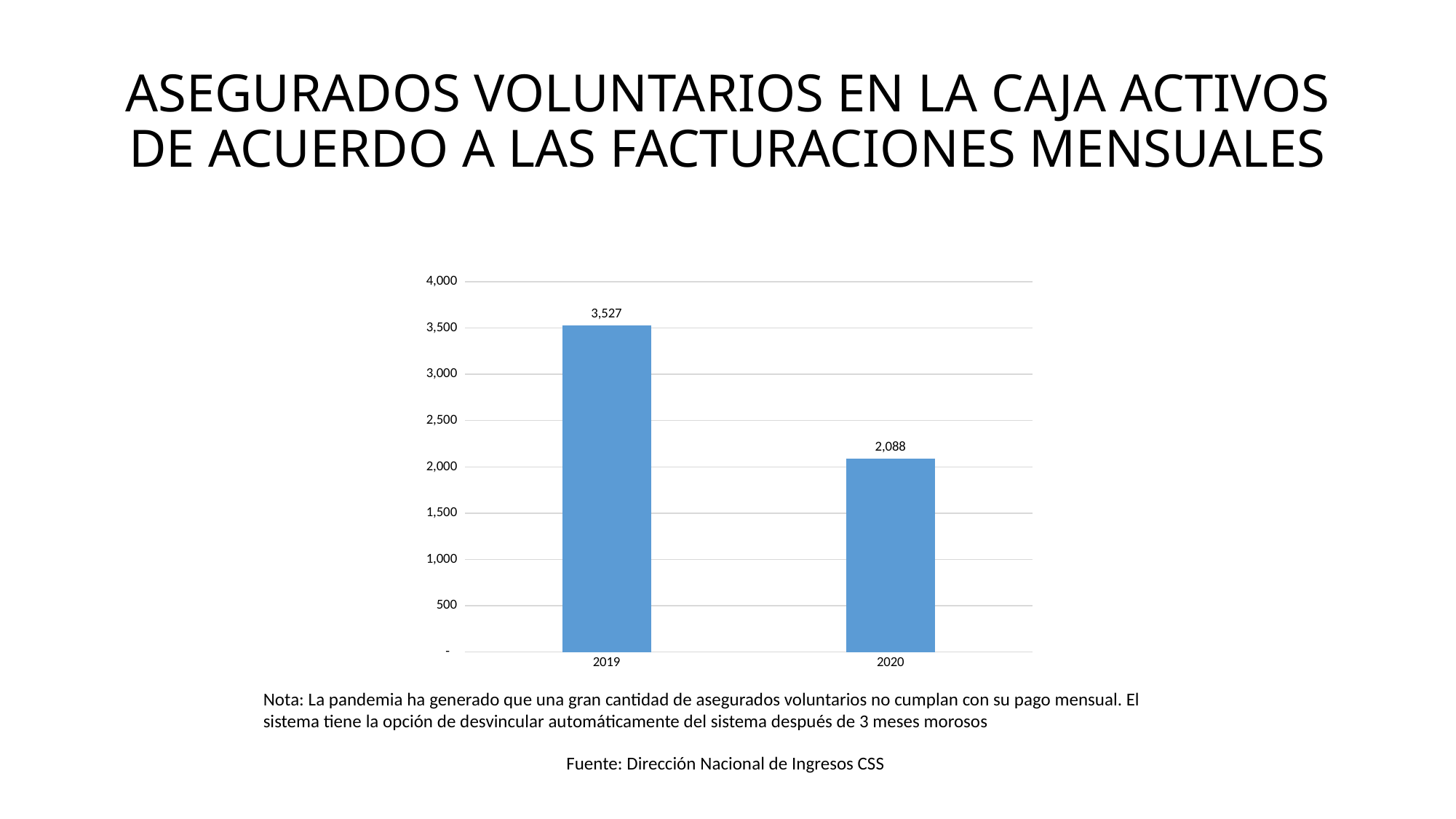
How many years are shown on the x axis? 2 Which is larger, the value for 2019 or the value for 2020? 2019 What kind of chart is shown on the slide? bar chart Do the values rise or fall from 2019 to 2020? fall Which year has the lowest value? 2020 What is the value for 2019? 3,527 What is the source cited below the chart? Dirección Nacional de Ingresos CSS What is the difference between the values for 2019 and 2020? 1,439 Is the value for 2020 greater or less than 2,500? less What is the value for 2020? 2,088 Is the value for 2019 greater or less than 3,000? greater Which year has the highest value? 2019